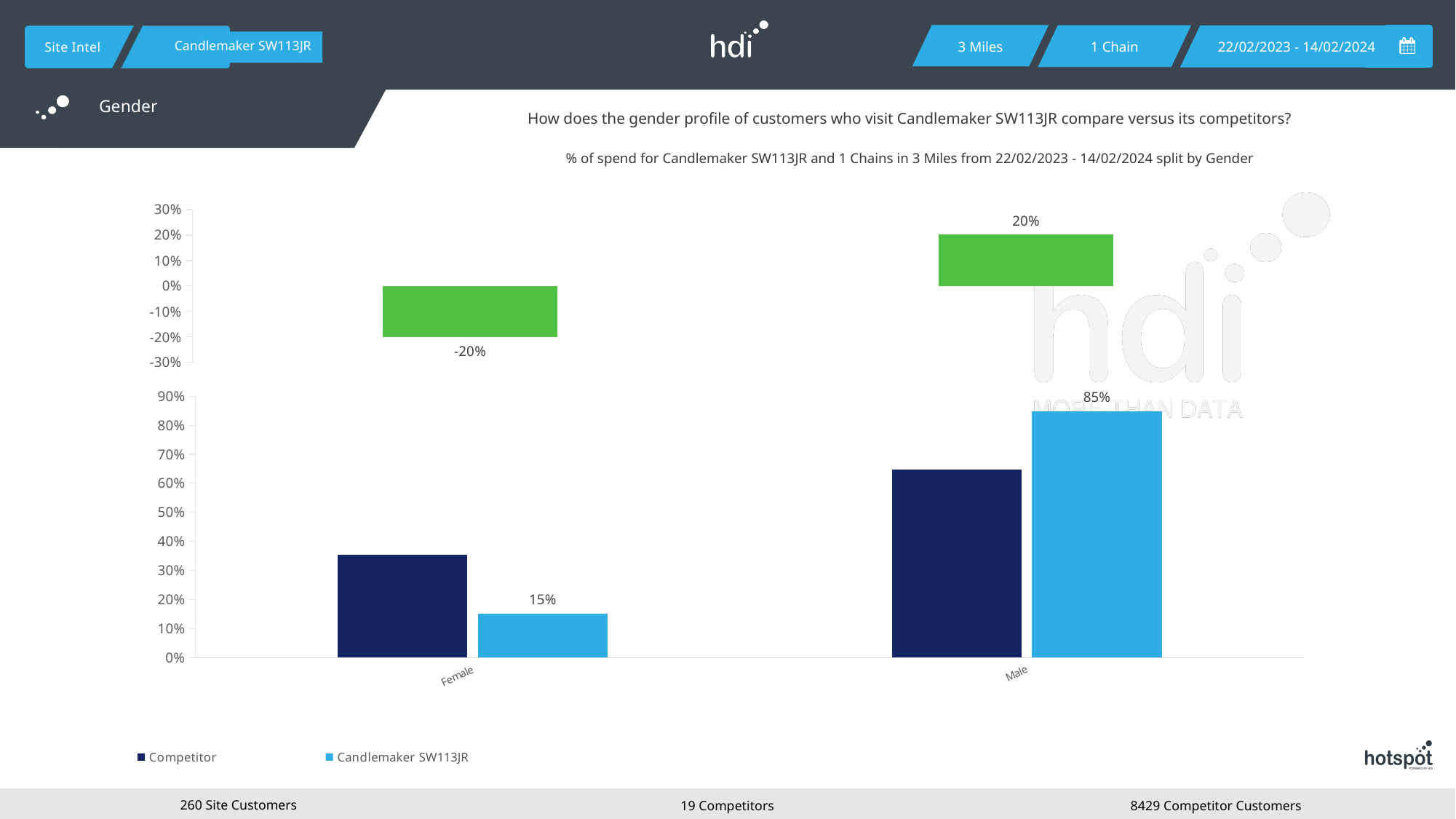
How many categories are shown on the x axis of the bottom chart? 2 In the bottom chart, which category has the highest value for Candlemaker SW113JR? Male In the bottom chart, what is the value for Candlemaker SW113JR in the Female category? 15% In the bottom chart, which is larger for the Male category: Competitor or Candlemaker SW113JR? Candlemaker SW113JR In the top chart, what is the value shown for the Female category? -20% In the bottom chart, what is the value for Candlemaker SW113JR in the Male category? 85% How many series does the legend of the bottom chart list? 2 In the bottom chart, is the Competitor value for Male greater or less than 70%? less In the bottom chart, is the Competitor value for Female greater or less than 30%? greater What kind of chart is the bottom chart? Bar chart In the top chart, what is the value shown for the Male category? 20% In the bottom chart, what is the difference between the Candlemaker SW113JR values for Male and Female? 70%